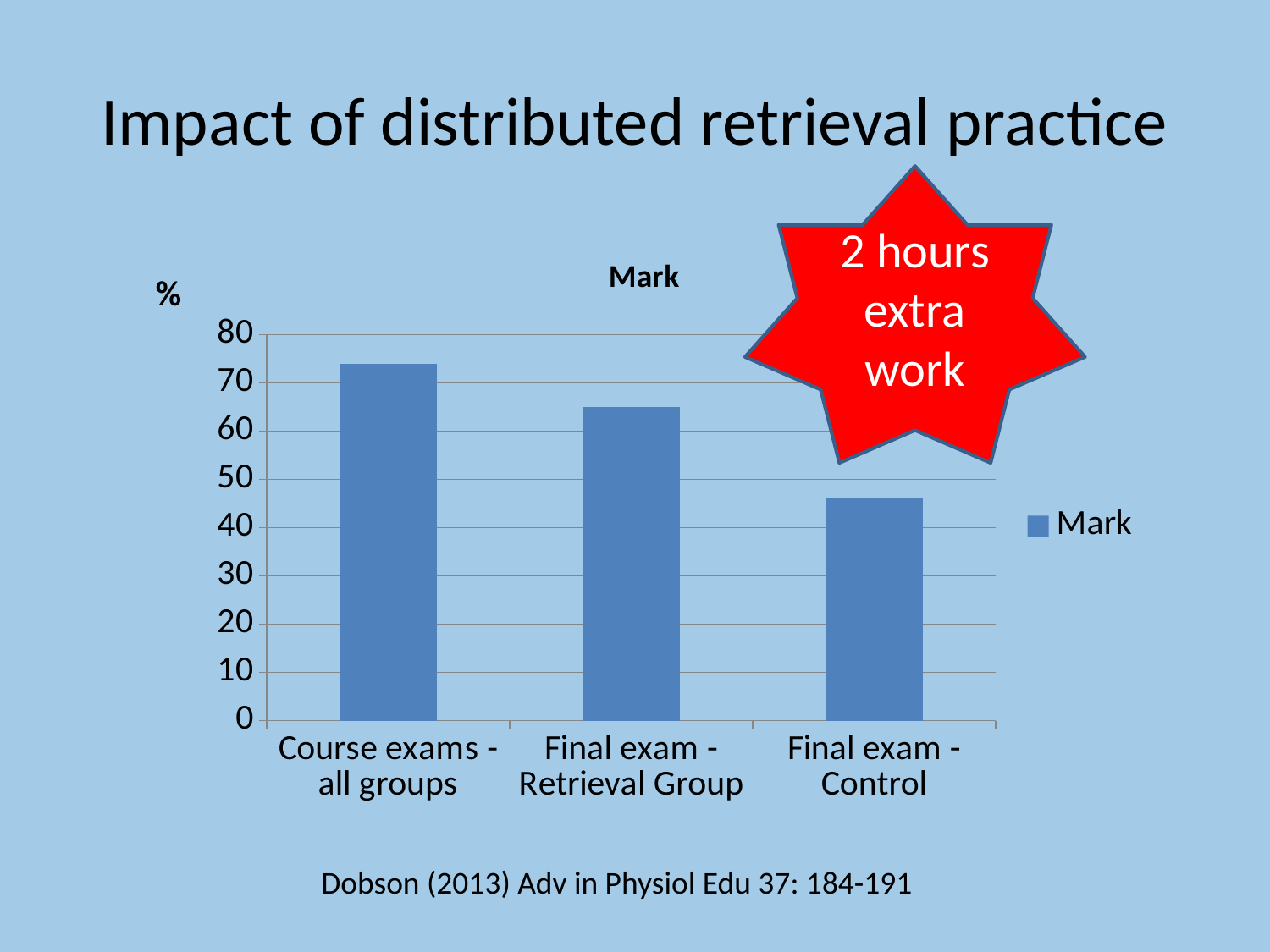
Do the values rise or fall from left to right along the x axis? fall Is the value for Course exams - all groups greater or less than 70? greater What is the title of the chart? Mark Which category has the highest mark? Course exams - all groups What type of chart is shown on the slide? bar chart Which category has the lowest mark? Final exam - Control What label is shown on the vertical axis of the chart? % Is the value for Final exam - Retrieval Group greater or less than 60? greater How many categories are shown on the x axis of the chart? 3 How many series does the chart legend list? 1 Is the value for Final exam - Control greater or less than 50? less Which is larger, the mark for Final exam - Retrieval Group or Final exam - Control? Final exam - Retrieval Group